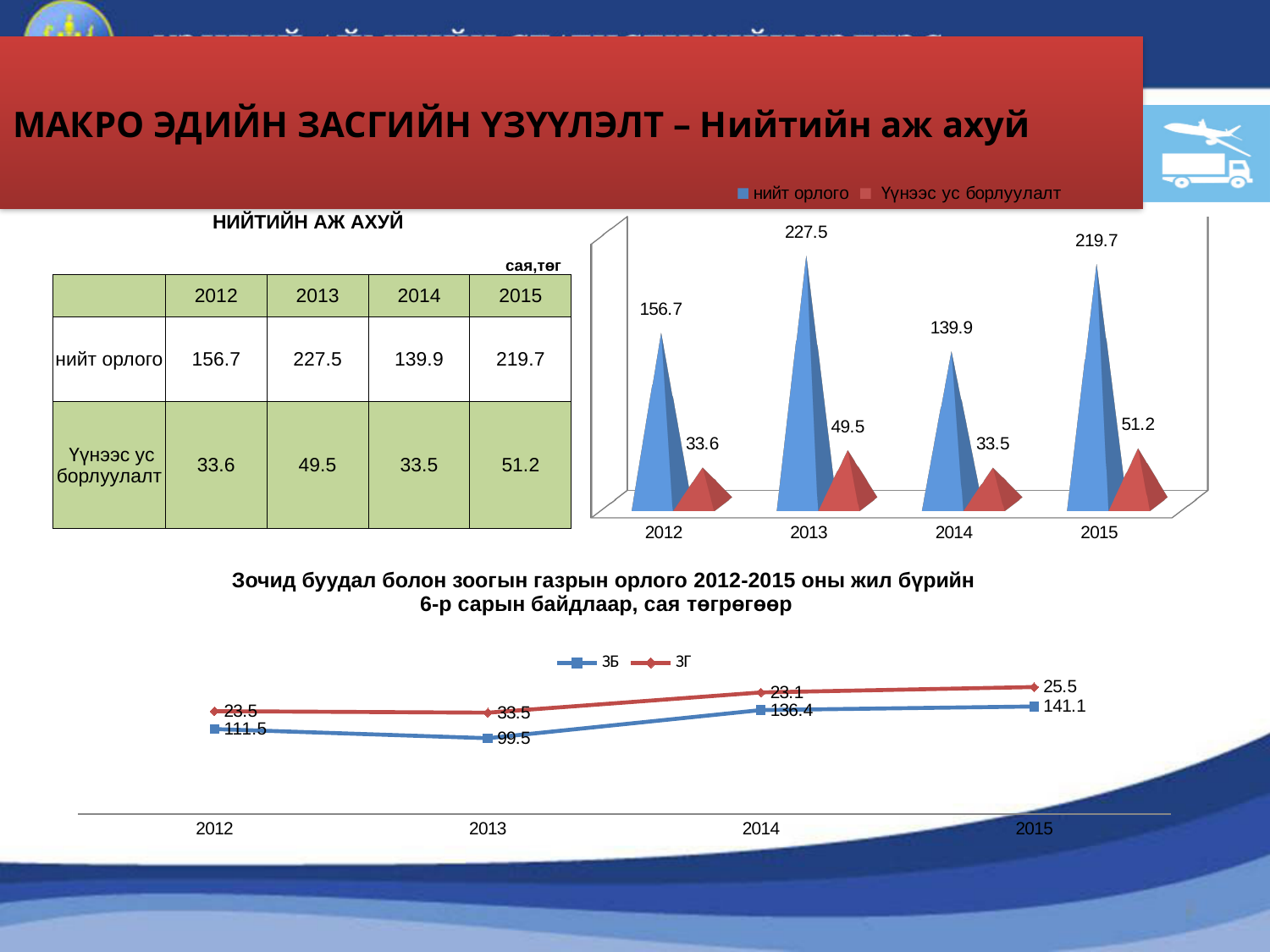
In the bottom line chart, how many years are shown on the x axis? 4 In the bottom line chart, what is the value of ЗГ for 2014? 23.1 In the top chart, what is the difference between нийт орлого in 2013 and in 2014? 87.6 In the top chart, how many series does the legend list? 2 In the bottom line chart, which year has the highest value for ЗБ? 2015 In the top chart, what is the value of нийт орлого for 2013? 227.5 In the top chart, which year has the highest value for Үүнээс ус борлуулалт? 2015 In the bottom line chart, is the value of ЗГ larger in 2013 or in 2015? 2013 In the top chart, what is the value of Үүнээс ус борлуулалт for 2015? 51.2 In the bottom line chart, what is the value of ЗБ for 2013? 99.5 What type of chart is the bottom chart on the slide? Line chart In the top chart, which year has the lowest value for нийт орлого? 2014